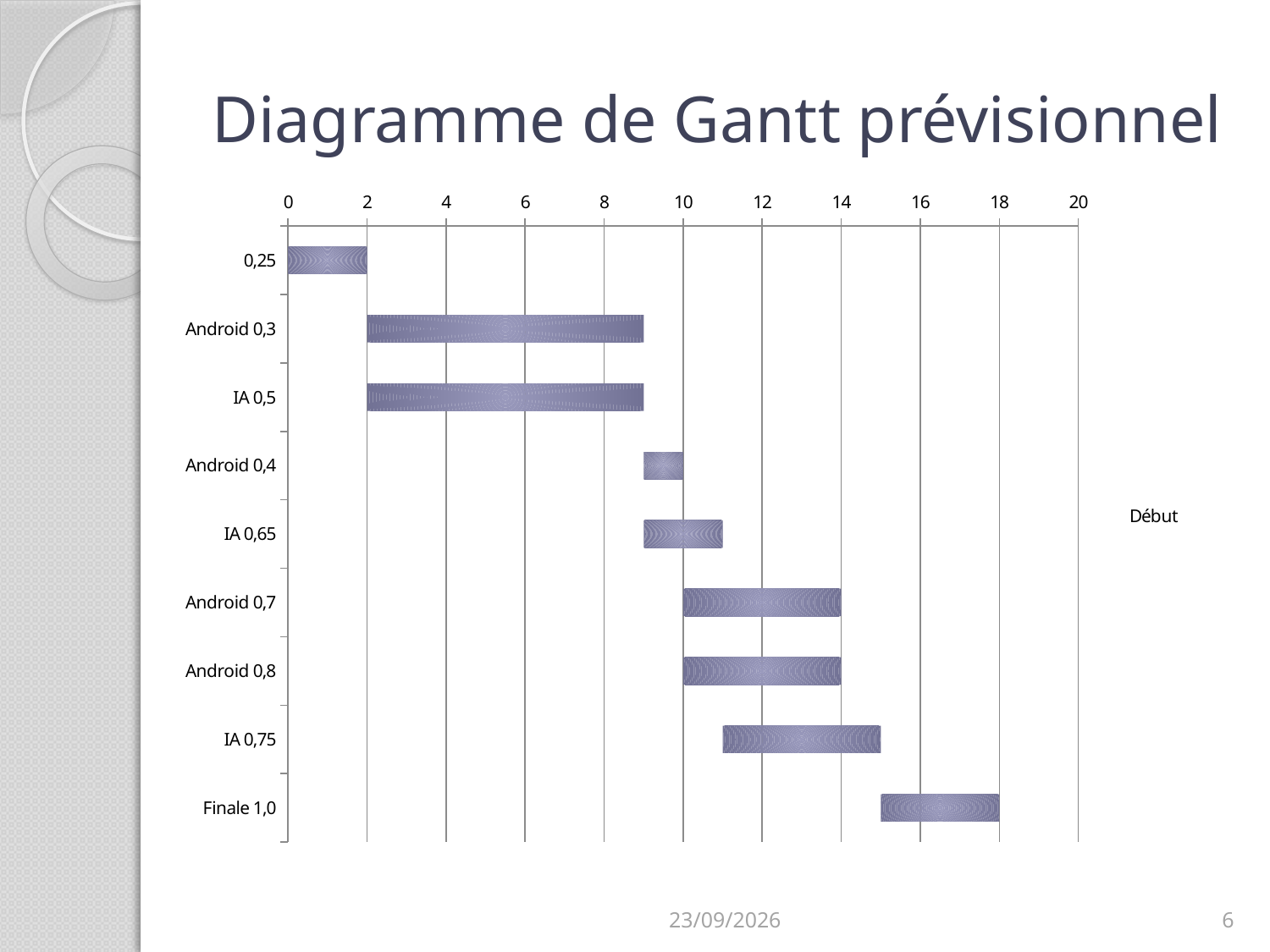
At what value on the horizontal axis does the bar for 0,25 end? 2 Which task has the shortest bar in the chart? Android 0,4 Which bar is longer, the one for IA 0,75 or the one for Android 0,4? IA 0,75 At what value on the horizontal axis does the bar for Android 0,8 end? 14 What kind of chart is shown on the slide? bar chart What is the title of the chart? Diagramme de Gantt prévisionnel At what value on the horizontal axis does the bar for Android 0,7 start? 10 What entry does the chart legend show? Début Is the start of the bar for Finale 1,0 greater or less than 14? greater Is the end of the bar for Android 0,3 greater or less than 10? less At what value on the horizontal axis does the bar for Finale 1,0 end? 18 How many tasks (categories) are listed on the vertical axis of the chart? 9